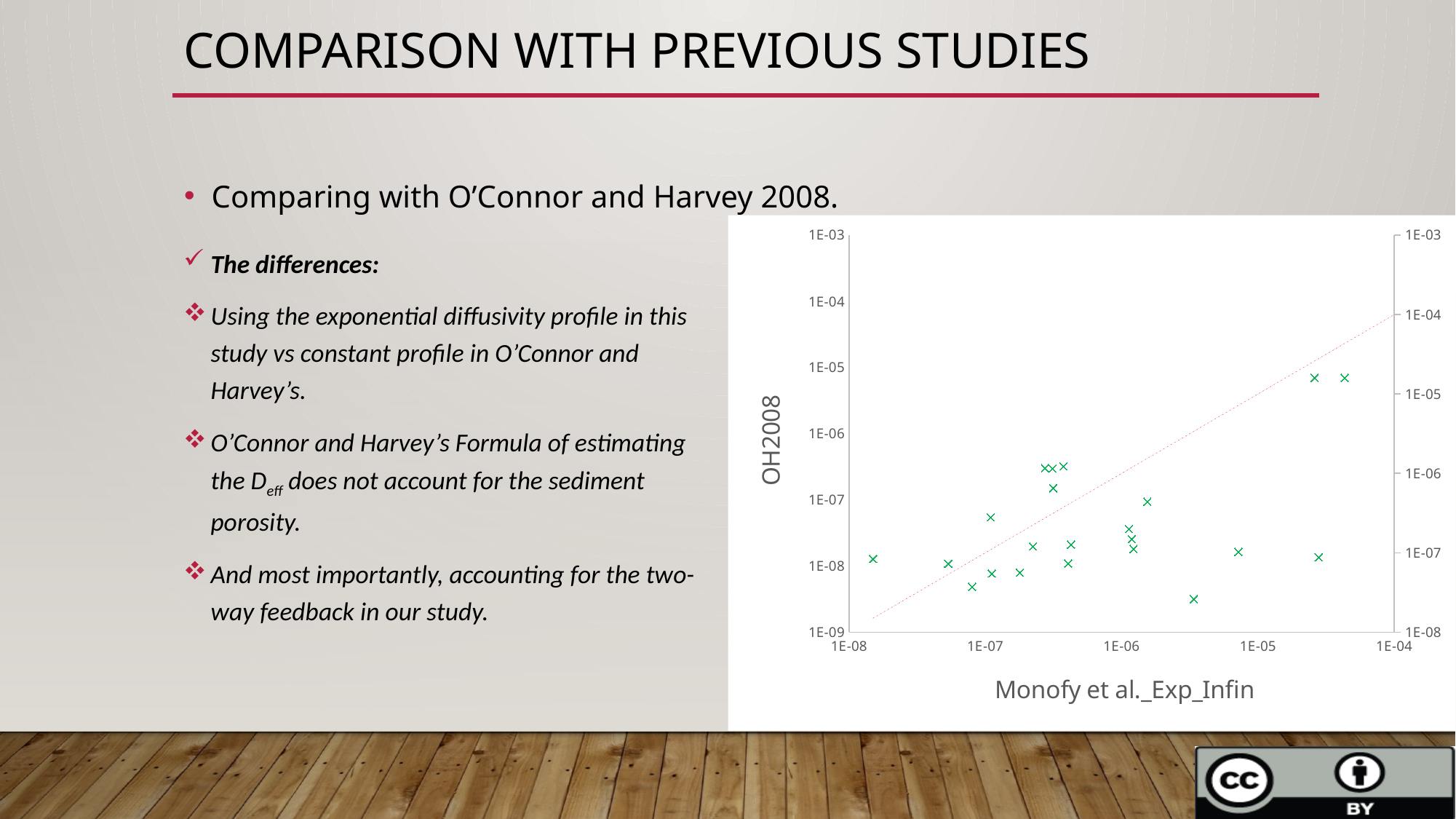
What is the label of the x axis of the chart? Monofy et al._Exp_Infin Is the x value of the rightmost data point in the chart greater or less than 1E-05? greater What is the highest tick value shown on the x axis of the chart? 1E-04 What is the lowest tick value shown on the left y axis of the chart? 1E-09 What is the lowest tick value shown on the x axis of the chart? 1E-08 What is the highest tick value shown on the left y axis of the chart? 1E-03 What is the label of the y axis of the chart? OH2008 Is the x value of the lowest data point in the chart greater or less than 1E-06? greater Is the x value of the leftmost data point in the chart greater or less than 1E-07? less What kind of chart is shown on the slide? scatter chart How many tick labels are shown on the x axis of the chart? 5